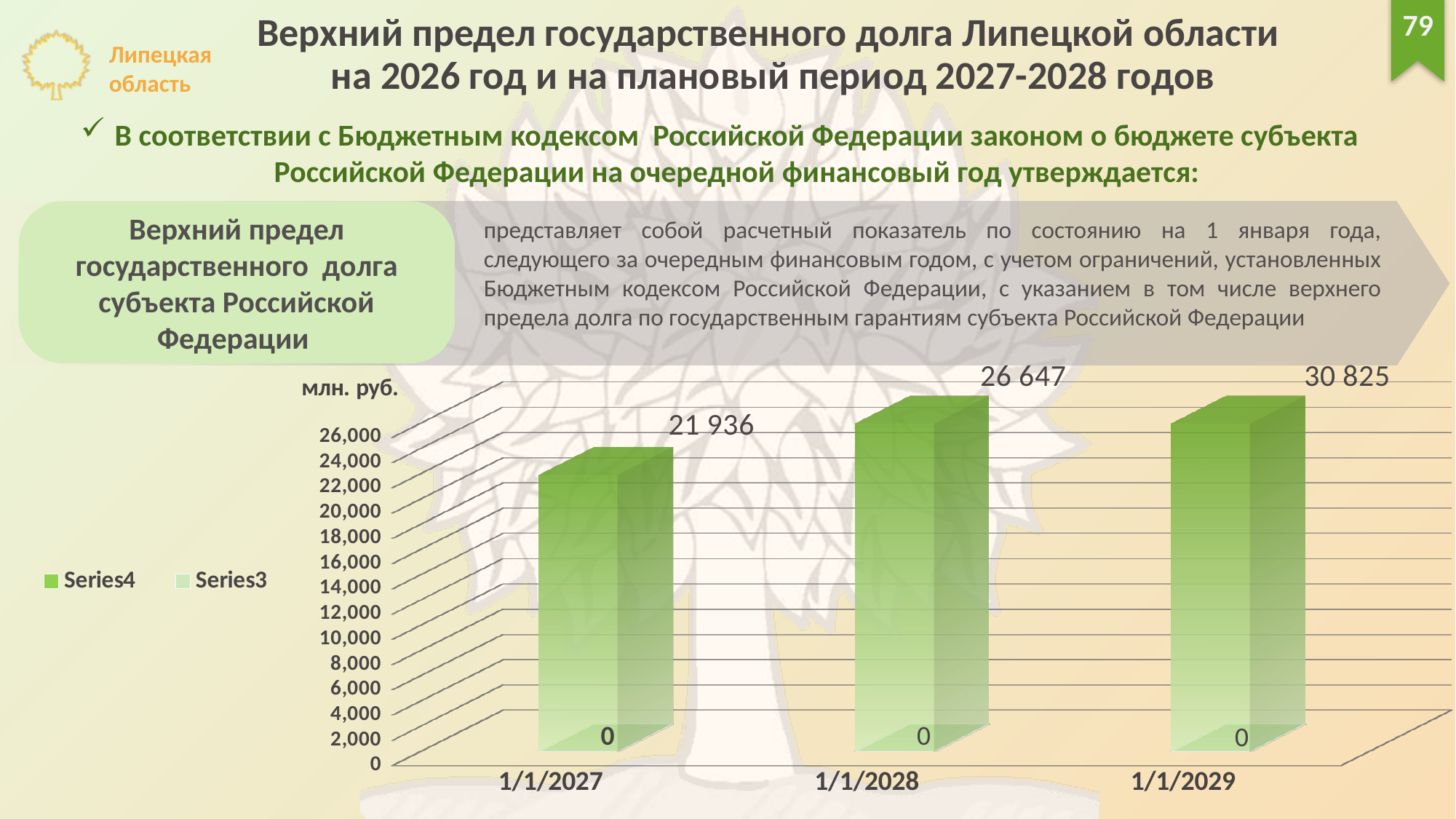
Do the values rise or fall from 1/1/2027 to 1/1/2029? rise How many dates are shown on the x axis of the chart? 3 What is the value shown for 1/1/2027? 21 936 Which is larger, the value for 1/1/2028 or the value for 1/1/2029? 1/1/2029 Which date has the highest value on the chart? 1/1/2029 What is the value shown for 1/1/2029? 30 825 Is the value for 1/1/2027 greater or less than 20,000? greater What is the difference between the values for 1/1/2028 and 1/1/2027? 4 711 Which date has the lowest non-zero value on the chart? 1/1/2027 What is the difference between the values for 1/1/2029 and 1/1/2027? 8 889 How many series does the chart legend list? 2 What is the value shown for 1/1/2028? 26 647